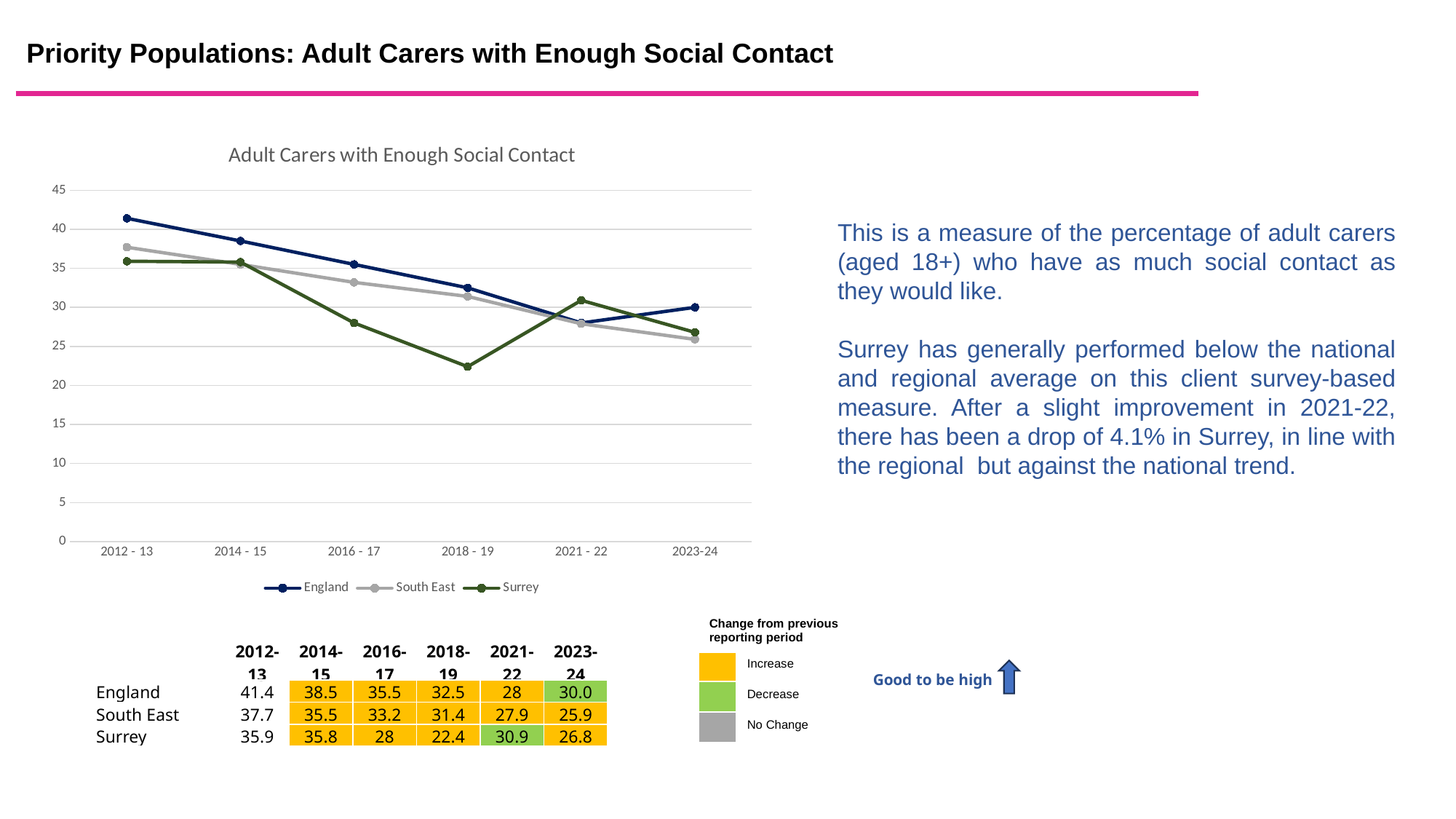
What is the value for England in 2012 - 13? 41.4 In 2021 - 22, which is larger: the value for Surrey or the value for England? Surrey What is the value for Surrey in 2018 - 19? 22.4 What kind of chart is shown on the slide? line chart How many reporting periods are plotted along the x axis? 6 Is the value for Surrey in 2018 - 19 greater or less than 25? less What is the difference between England's value in 2012 - 13 and in 2023-24? 11.4 Does the South East series rise or fall from 2012 - 13 to 2023-24? fall In which period does Surrey reach its lowest value? 2018 - 19 What is the value for South East in 2023-24? 25.9 Which series has the highest value in 2012 - 13? England How many series does the chart legend list? 3